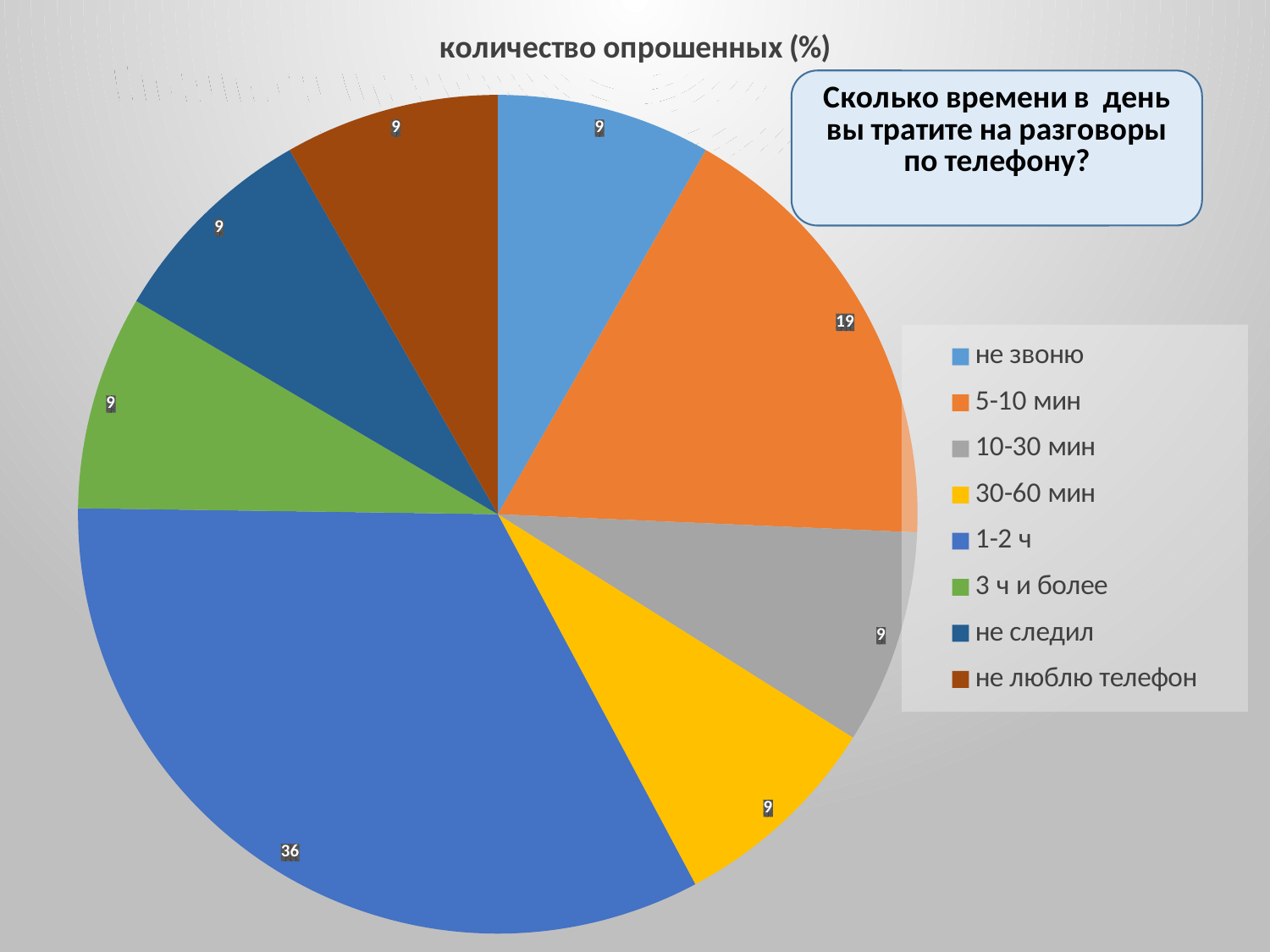
What is the title of the chart? количество опрошенных (%) Which is larger, the value for "5-10 мин" or the value for "10-30 мин"? 5-10 мин What is the value for the slice "5-10 мин"? 19 What kind of chart is shown on the slide? pie chart What is the difference between the values for "1-2 ч" and "5-10 мин"? 17 How many slices does the pie chart have? 8 Which category has the largest slice of the pie? 1-2 ч What is the value for the slice "не звоню"? 9 What is the difference between the values for "5-10 мин" and "30-60 мин"? 10 How many entries does the legend list? 8 What colour is the slice for "3 ч и более"? green What is the value for the slice "1-2 ч"? 36